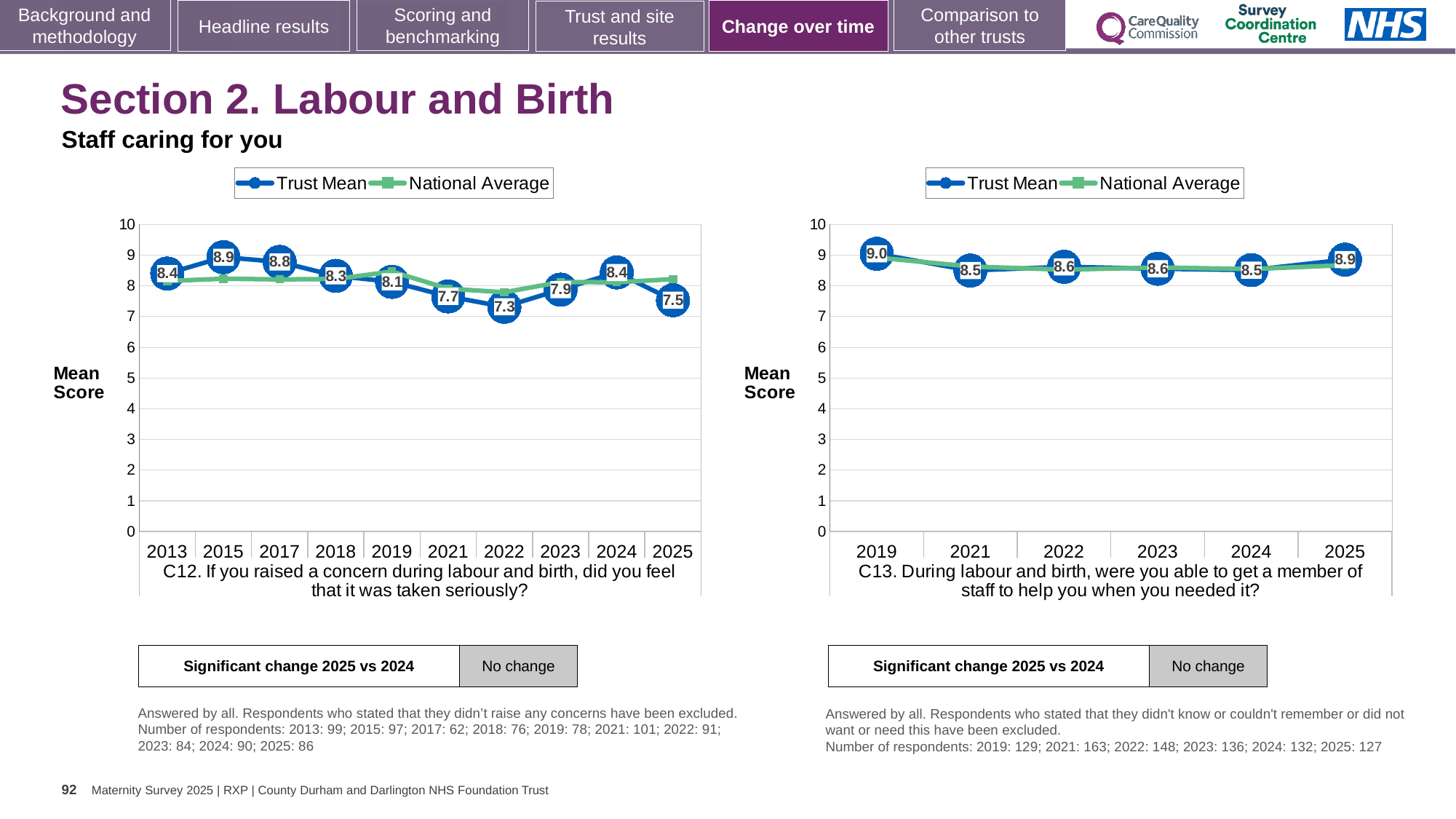
In the C13 chart (right), what is the Trust Mean for 2019? 9.0 In the C12 chart (left), which year has the lowest Trust Mean? 2022 In the C12 chart (left), what is the Trust Mean for 2025? 7.5 In the C12 chart (left), how many years are plotted on the x axis? 10 In the C13 chart (right), which year has the highest Trust Mean? 2019 In the C12 chart (left), what is the difference between the Trust Mean for 2024 and 2025? 0.9 In the C12 chart (left), what is the Trust Mean for 2022? 7.3 What type of chart is the C12 chart (left)? Line chart In the C13 chart (right), is the National Average for 2021 greater or less than 9? less How many series does the legend of the C13 chart (right) list? 2 In the C12 chart (left), which year has the highest Trust Mean? 2015 In the C13 chart (right), is the Trust Mean for 2025 larger or smaller than for 2024? larger